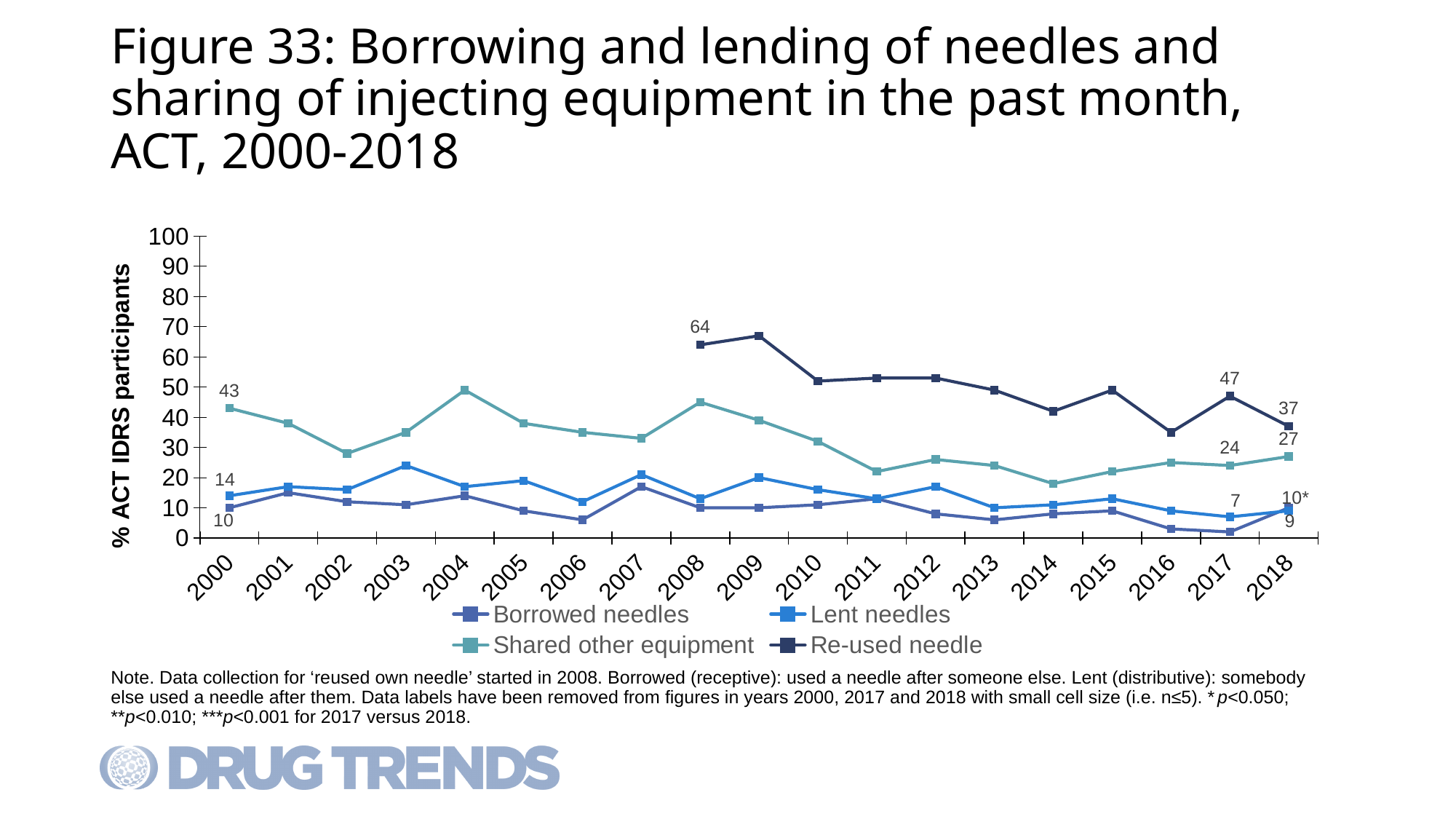
What is the label on the y axis? % ACT IDRS participants What is the value for Lent needles in 2017? 7 What kind of chart is shown on the slide? Line chart What is the value for Re-used needle in 2008? 64 In 2018, which is larger: Re-used needle or Shared other equipment? Re-used needle Is the value for Shared other equipment in 2004 greater or less than 40? greater What is the value for Shared other equipment in 2000? 43 How many series does the legend list? 4 What is the difference between the Shared other equipment values in 2018 and 2017? 3 How many years are shown on the x axis? 19 What is the value for Re-used needle in 2018? 37 What is the difference between the Re-used needle values in 2017 and 2018? 10